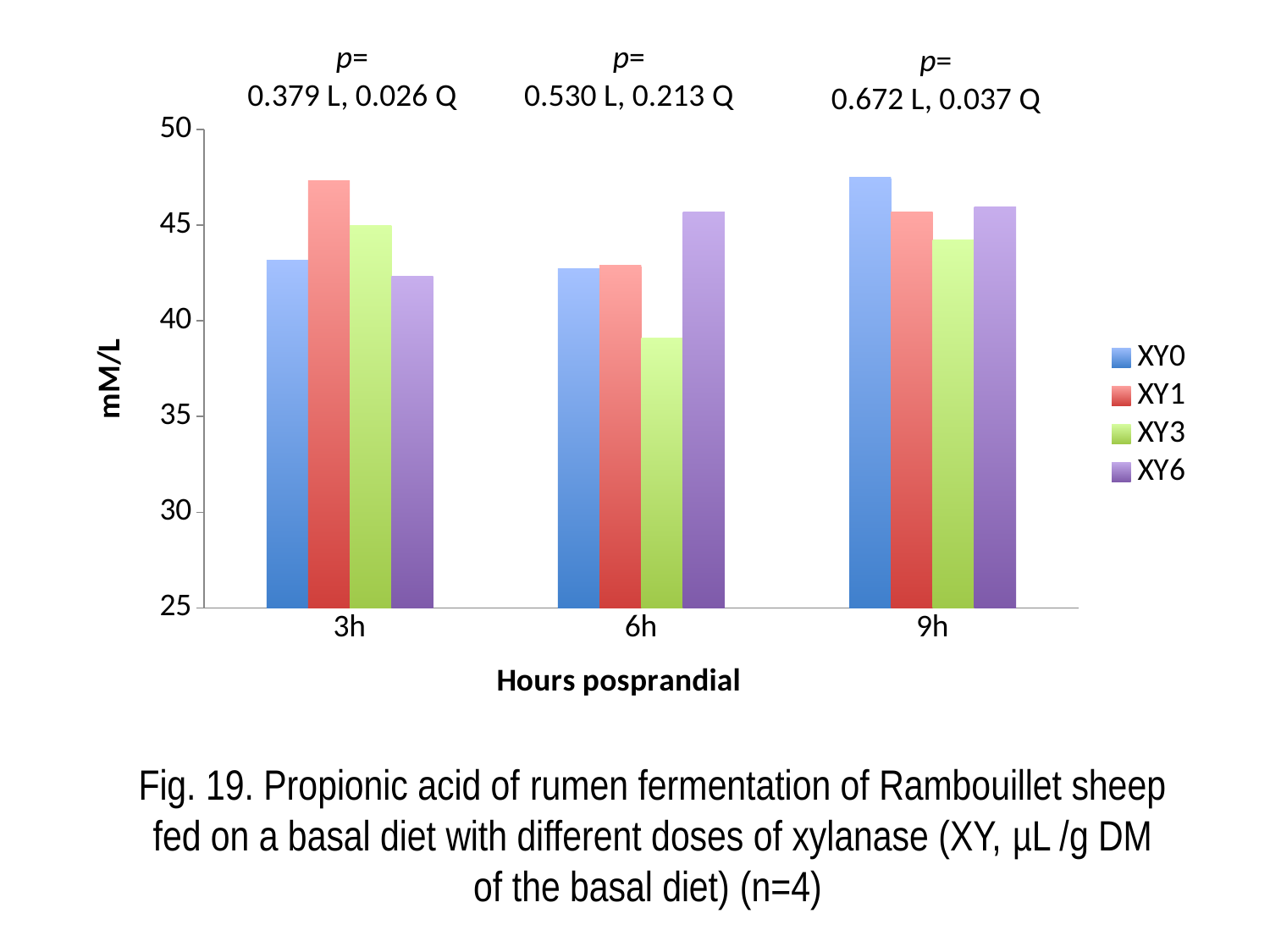
What is the label on the y axis? mM/L What kind of chart is shown on the slide? bar chart Which series has the highest value at 3h? XY1 Is the value for XY1 at 3h greater or less than 45? greater Is the value for XY0 at 9h greater or less than 45? greater Which series has the lowest value at 6h? XY3 At 6h, which is larger, the value for XY6 or the value for XY3? XY6 Is the value for XY6 at 3h greater or less than 45? less How many series does the legend list? 4 Which series has the highest value at 9h? XY0 How many time points (categories) are shown on the x axis? 3